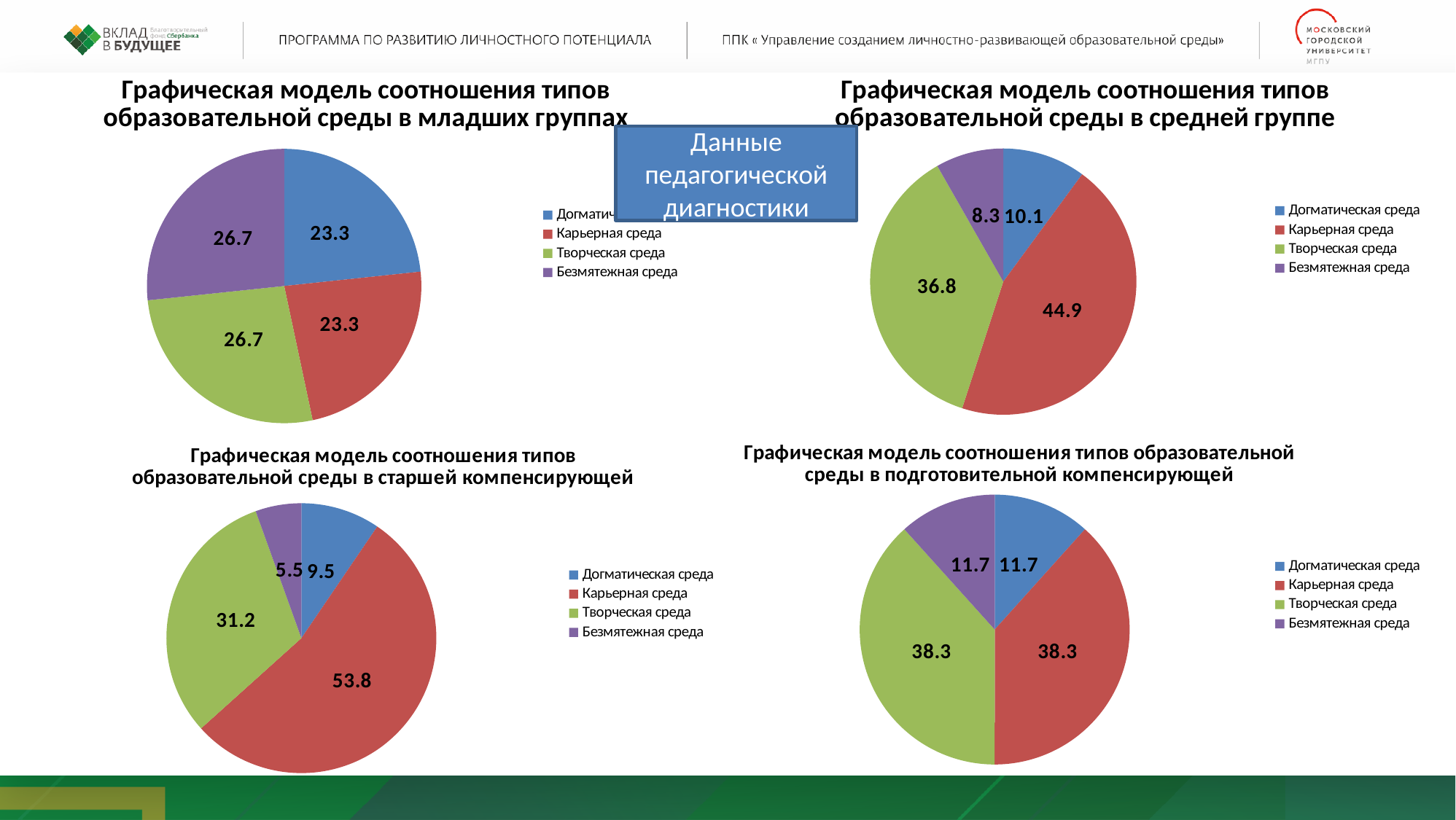
In the chart for the старшая компенсирующая group (bottom left), what is the value for Безмятежная среда? 5.5 In the chart for the старшая компенсирующая group (bottom left), what is the difference between Карьерная среда and Творческая среда? 22.6 What type of chart is used for the младшие группы (top left)? Pie chart In the chart for the средняя группа (top right), which is larger: Догматическая среда or Творческая среда? Творческая среда How many charts are shown on the slide? 4 In the chart for the старшая компенсирующая group (bottom left), which category has the largest slice? Карьерная среда How many slices does the chart for the подготовительная компенсирующая group (bottom right) have? 4 In the chart for the средняя группа (top right), what is the value for Карьерная среда? 44.9 In the chart for the подготовительная компенсирующая group (bottom right), what is the value for Догматическая среда? 11.7 In the chart for the средняя группа (top right), what is the difference between Карьерная среда and Творческая среда? 8.1 In the chart for the средняя группа (top right), which category has the smallest slice? Безмятежная среда In the chart for the младшие группы (top left), what is the value for Творческая среда? 26.7